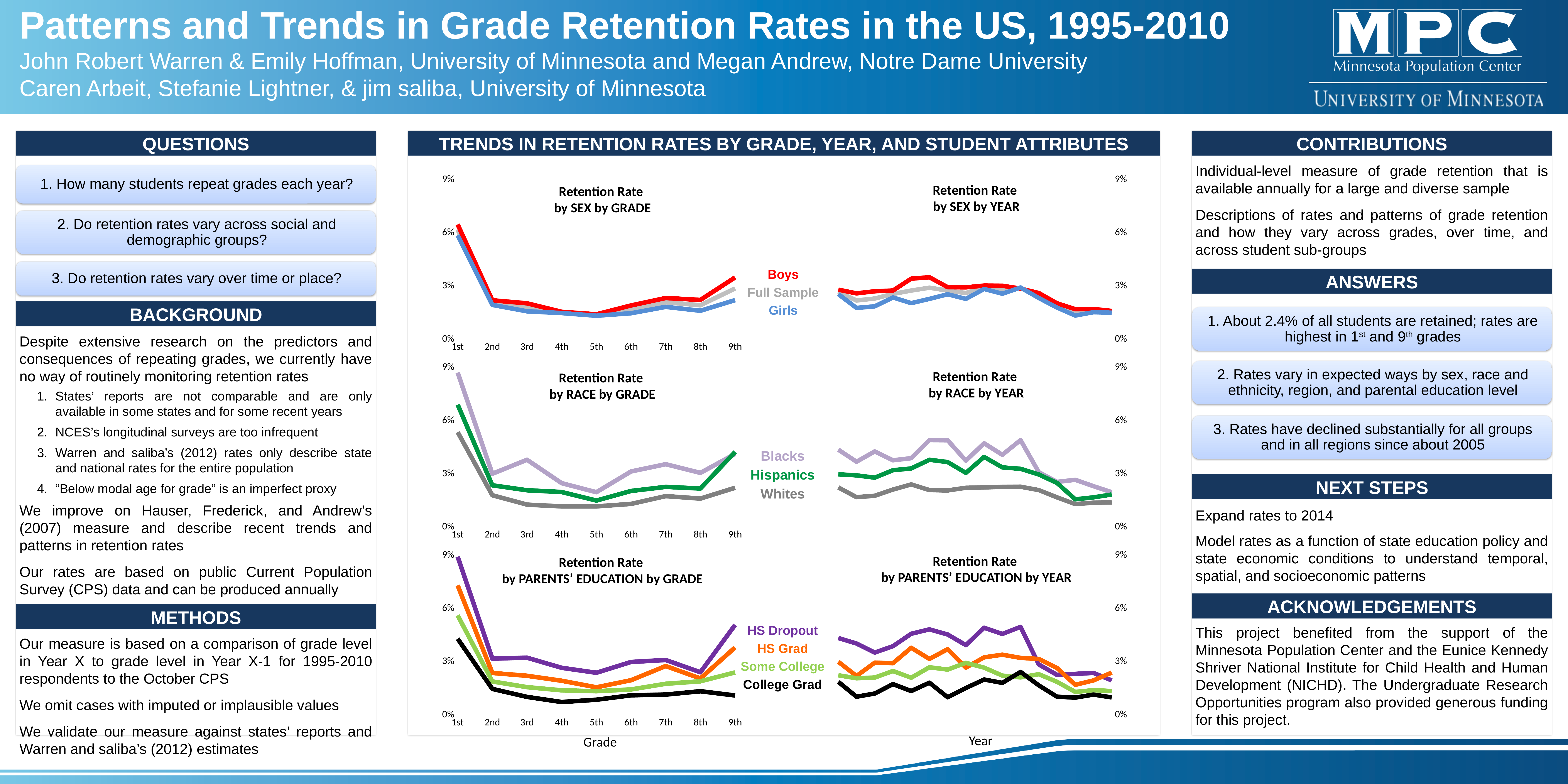
How many series are labelled on the "Retention Rate by SEX by GRADE" chart? 3 In the "Retention Rate by RACE by GRADE" chart, is the value for Blacks at 1st grade greater or less than 6%? greater In the "Retention Rate by PARENTS' EDUCATION by GRADE" chart, is the value for HS Dropout at 1st grade greater or less than 6%? greater In the "Retention Rate by RACE by GRADE" chart, at which grade is the retention rate for Blacks highest? 1st How many grade categories are shown on the x axis of the "Retention Rate by RACE by GRADE" chart? 9 In the "Retention Rate by SEX by GRADE" chart, which series is drawn in red? Boys In the "Retention Rate by PARENTS' EDUCATION by GRADE" chart, which has the higher retention rate at 1st grade, HS Dropout or College Grad? HS Dropout What kind of chart is the "Retention Rate by SEX by GRADE" chart? line chart How many series are labelled on the "Retention Rate by PARENTS' EDUCATION by GRADE" chart? 4 In the "Retention Rate by SEX by GRADE" chart, is the value for Boys at 5th grade greater or less than 3%? less In the "Retention Rate by RACE by GRADE" chart, which has the higher retention rate at 1st grade, Blacks or Whites? Blacks In the "Retention Rate by SEX by GRADE" chart, does the Boys line rise or fall from 1st grade to 5th grade? fall